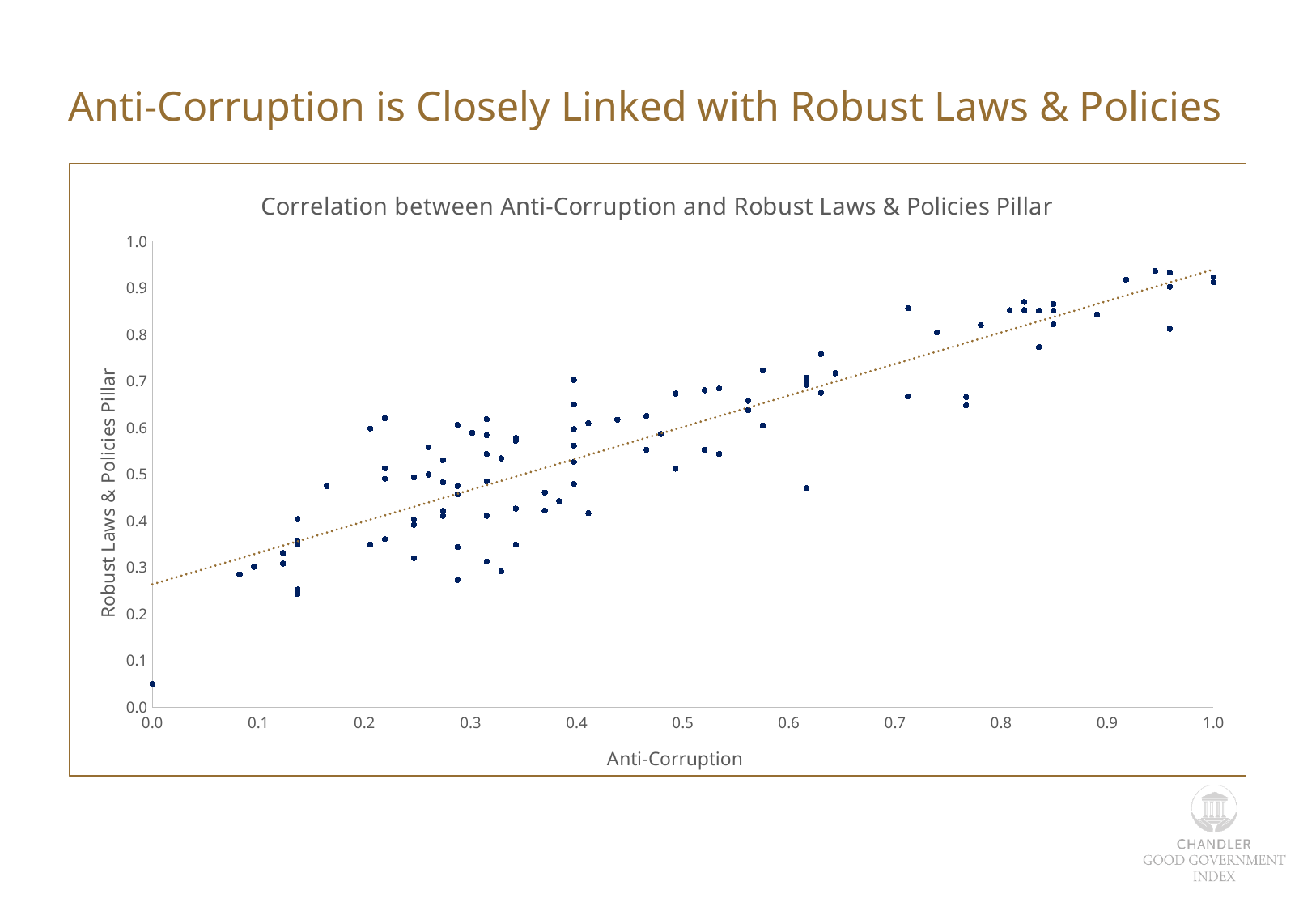
Is the Robust Laws & Policies Pillar value for the point at Anti-Corruption 0.0 greater or less than 0.5? less Is the Robust Laws & Policies Pillar value for the point at Anti-Corruption 0.0 greater or less than 0.1? less What is the label of the y axis? Robust Laws & Policies Pillar What kind of chart is shown on the slide? scatter plot What is the title of the chart? Correlation between Anti-Corruption and Robust Laws & Policies Pillar As Anti-Corruption increases along the x axis, do the Robust Laws & Policies Pillar values generally rise or fall? rise